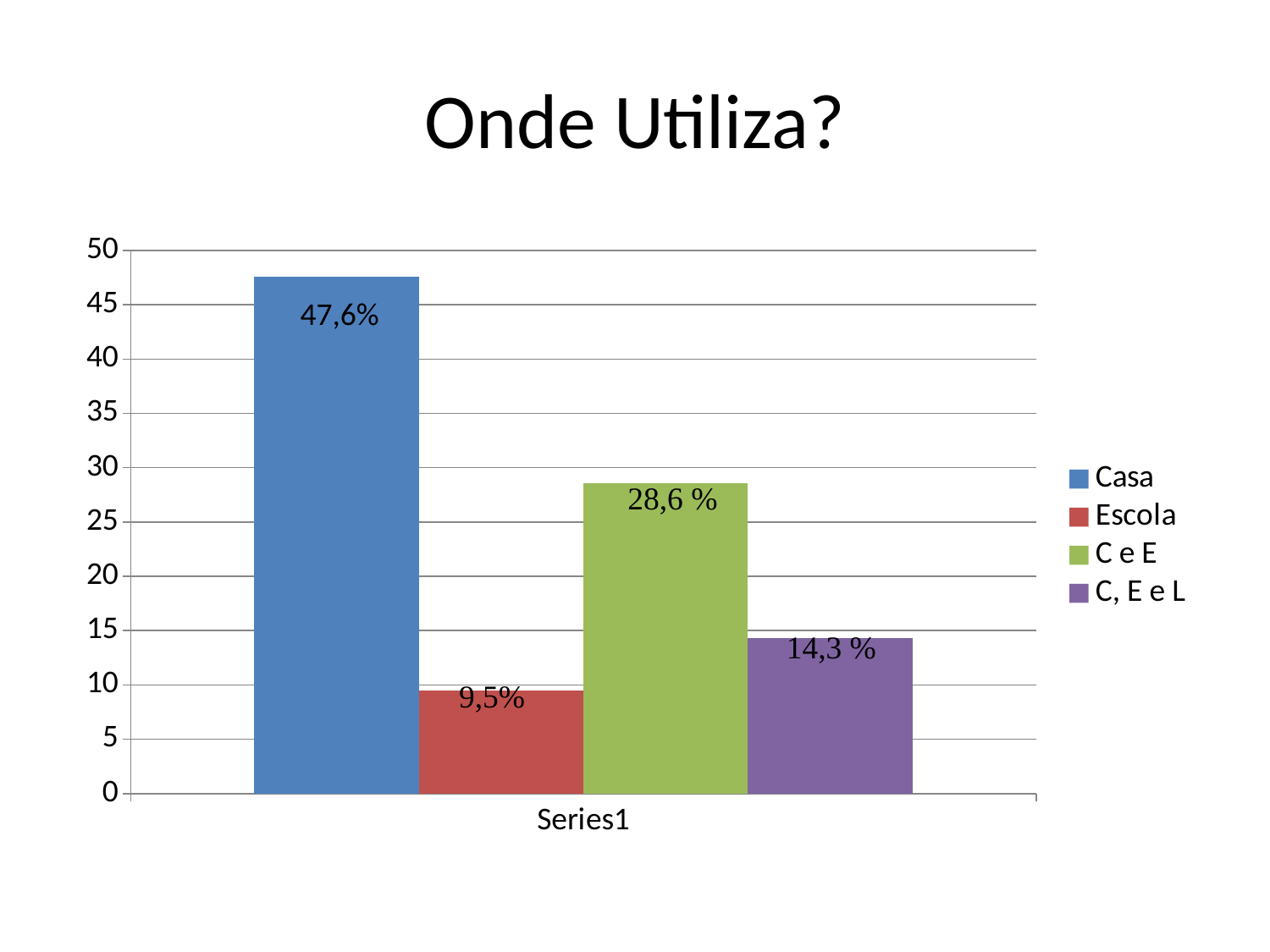
Is the value for Casa greater or less than 45? greater What is the value shown for C, E e L? 14,3 % How many entries does the legend list? 4 Which category has the highest value? Casa Which is larger, the value for C e E or the value for C, E e L? C e E What is the difference between the value for C e E and the value for C, E e L? 14,3 What is the value shown for Escola? 9,5% What is the value shown for Casa? 47,6% What is the title of the chart? Onde Utiliza? Which category has the lowest value? Escola What is the value shown for C e E? 28,6 % What type of chart is shown on the slide? bar chart